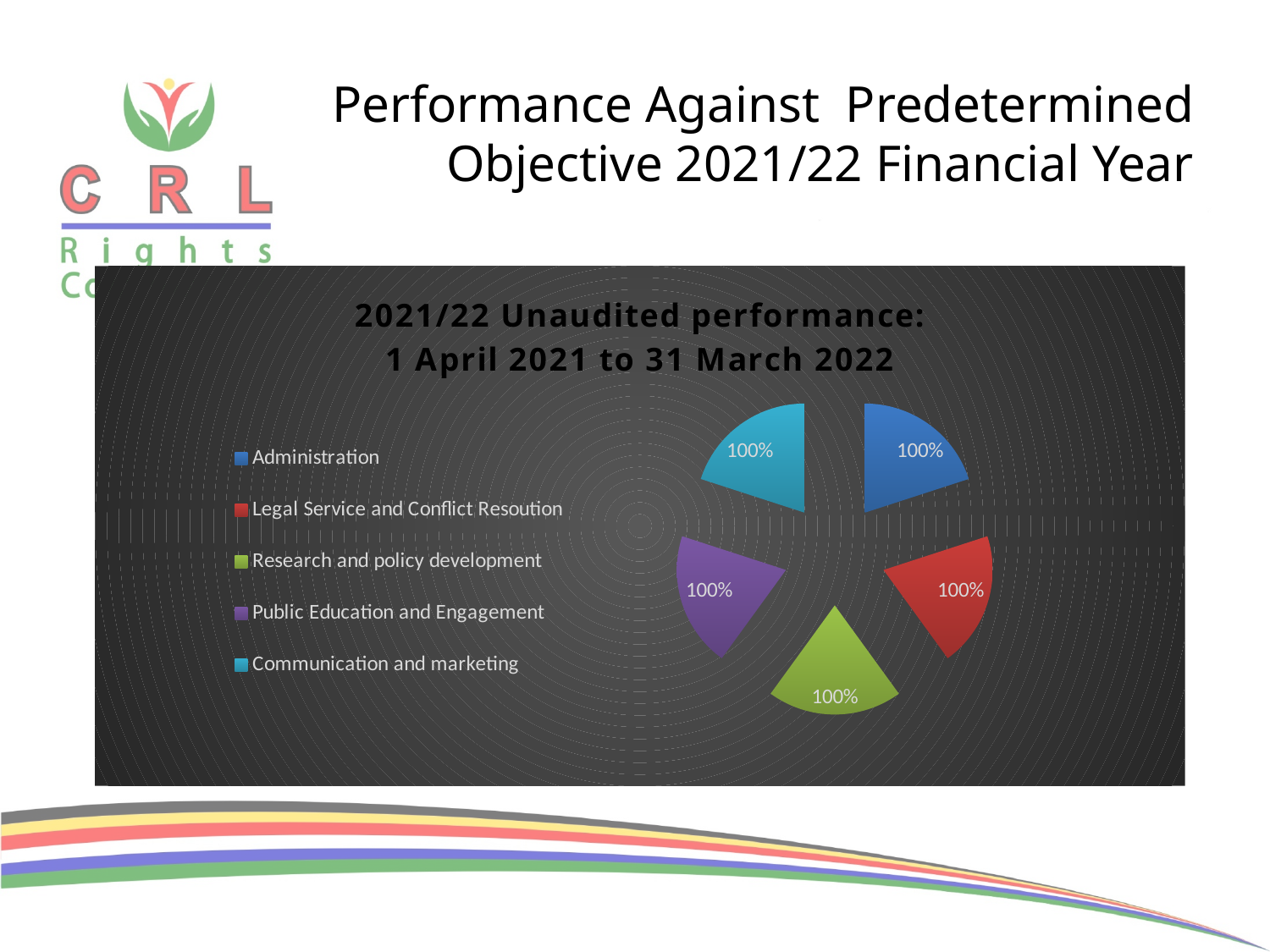
What is the title of the chart? 2021/22 Unaudited performance: 1 April 2021 to 31 March 2022 What value is shown for Research and policy development? 100% Which colour represents Research and policy development in the legend? green What value is shown for Administration? 100% What kind of chart is shown on the slide? pie chart What value is shown for Legal Service and Conflict Resoution? 100% What value is shown for Communication and marketing? 100% How many slices does the pie chart have? 5 What value is shown for Public Education and Engagement? 100% What is the difference between the values for Administration and Communication and marketing? 0% How many entries does the chart legend list? 5